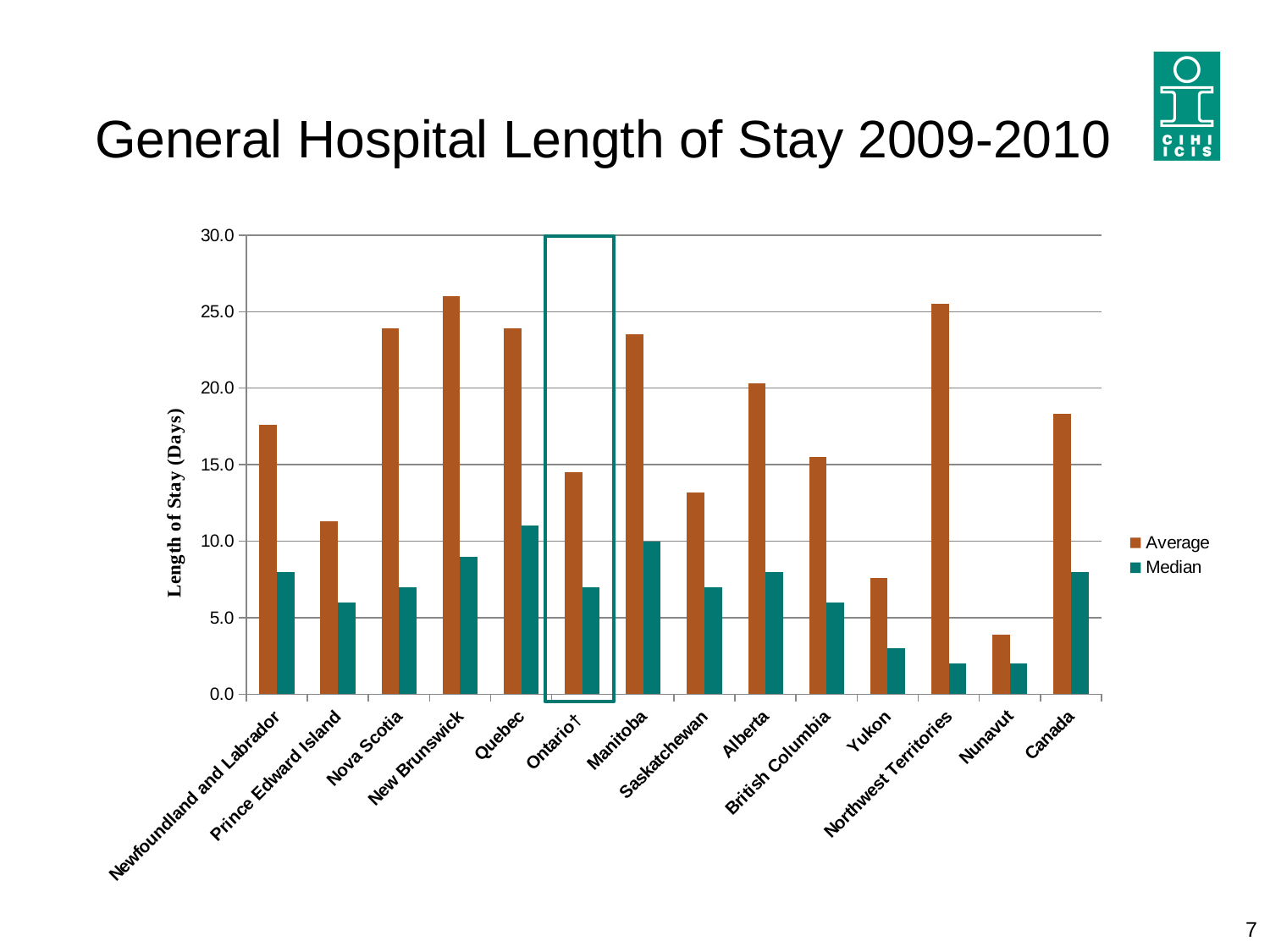
Is the Average value for Nova Scotia greater or less than 20? greater Which is larger, the Average value for Nova Scotia or the Average value for Ontario†? Nova Scotia Which is larger, the Median value for Manitoba or the Median value for Ontario†? Manitoba Which category has the lowest Average length of stay? Nunavut What type of chart is shown on the slide? Bar chart How many categories are shown on the x axis? 14 Is the Average value for Yukon greater or less than 10? less How many series does the legend list? 2 What is the label of the y axis? Length of Stay (Days) Is the Average value for Ontario† greater or less than 15? less Which category has the highest Median length of stay? Quebec